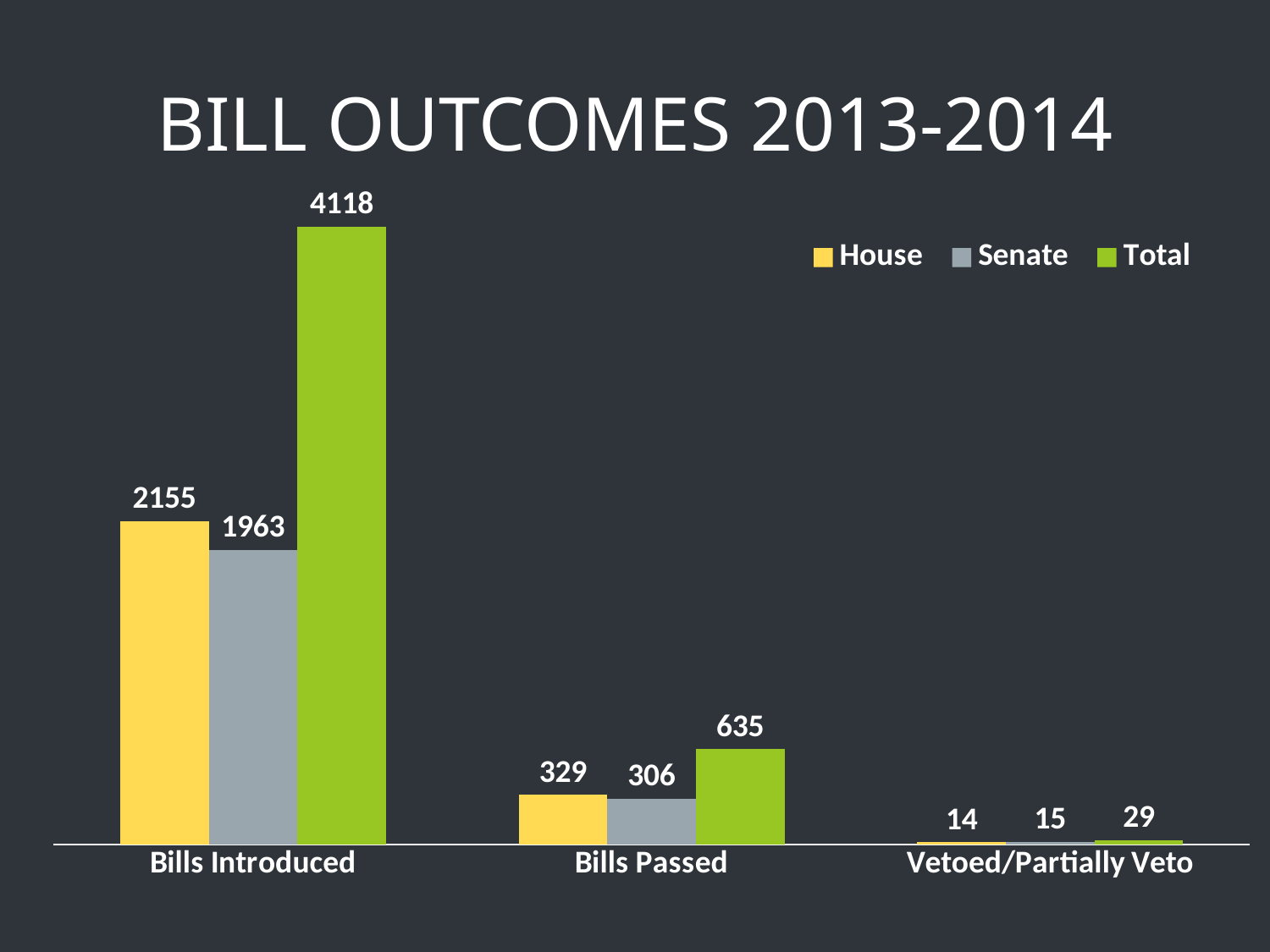
What is the House value for Bills Introduced? 2155 What kind of chart is shown on the slide? Bar chart What is the title of the chart? BILL OUTCOMES 2013-2014 Which is larger for Bills Passed, the House value or the Senate value? House What is the Total value for Vetoed/Partially Veto? 29 Which category has the highest Total value? Bills Introduced What is the difference between the House and Senate values for Bills Introduced? 192 How many series does the legend list? 3 What is the Senate value for Bills Passed? 306 Which is larger for Vetoed/Partially Veto, the House value or the Senate value? Senate How many categories are shown on the x axis? 3 Which category has the lowest House value? Vetoed/Partially Veto